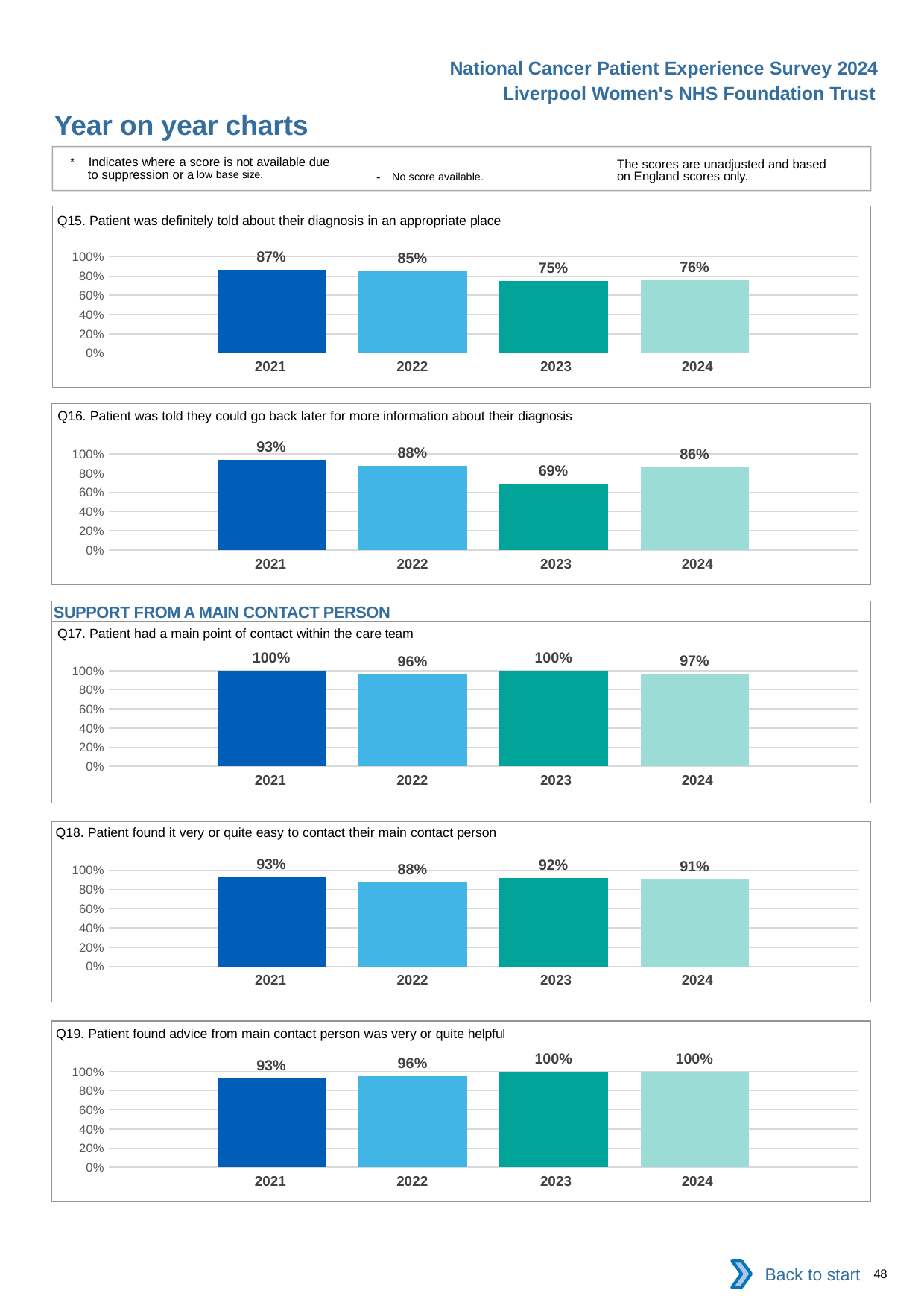
What kind of chart is the Q18 chart? bar chart In the Q18 chart, which is larger, the value for 2023 or the value for 2022? 2023 In the Q16 chart, what is the difference between the 2021 and 2023 values? 24 percentage points How many years are shown in the Q15 chart? 4 What is the section heading shown above the Q17 chart? SUPPORT FROM A MAIN CONTACT PERSON In the Q19 chart, do the values rise or fall from 2021 to 2024? rise In the Q18 chart, what is the difference between the 2021 and 2022 values? 5 percentage points In the Q17 chart, what is the value for 2022? 96% In the Q15 chart, which year has the highest value? 2021 In the Q19 chart, what is the value for 2024? 100% In the Q15 chart, what is the value for 2021? 87% In the Q16 chart, which year has the lowest value? 2023